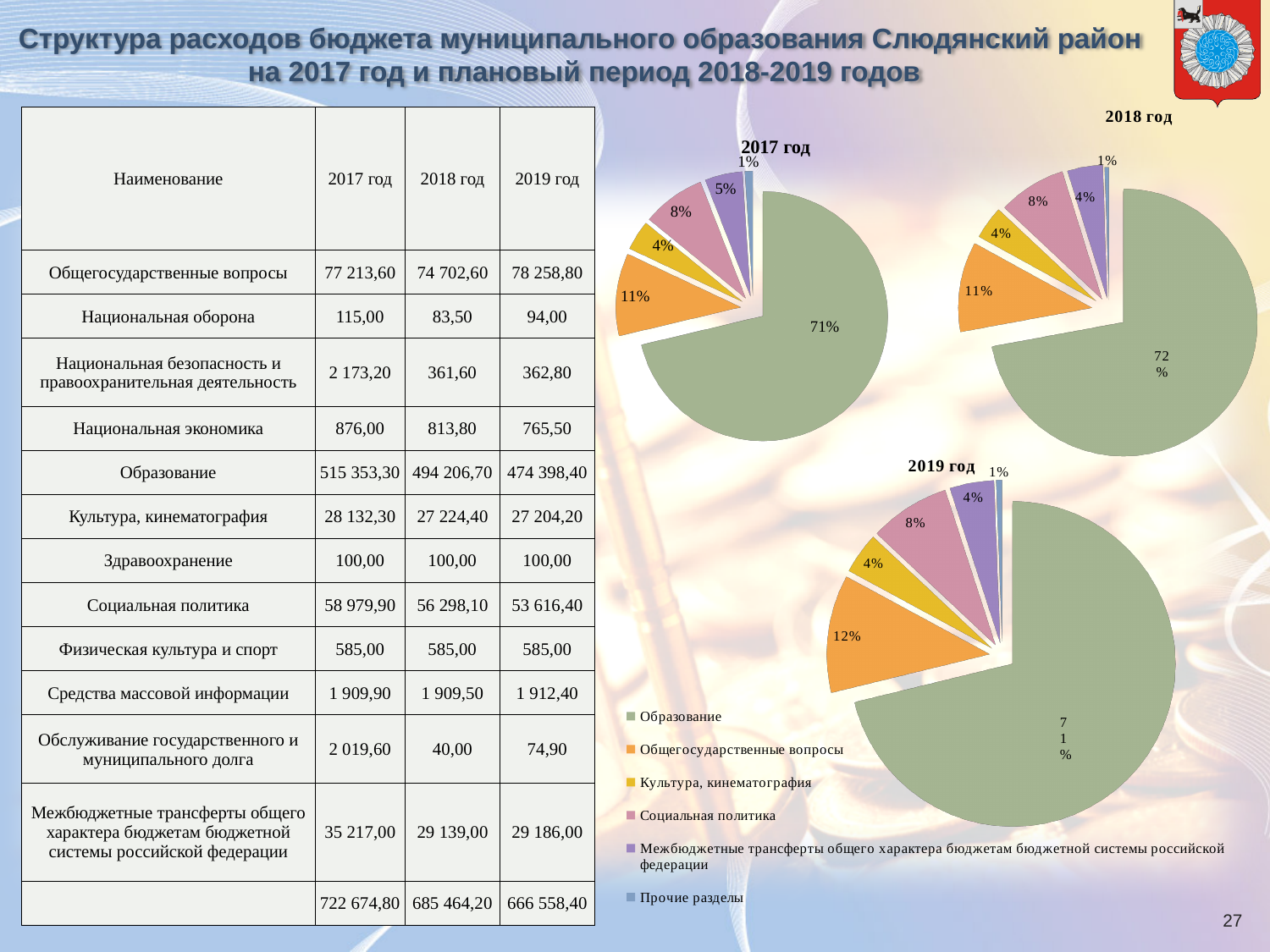
In the 2017 год pie chart, what share does Образование have? 71% In the 2019 год pie chart, what share does Общегосударственные вопросы have? 12% In the 2017 год pie chart, what share does Межбюджетные трансферты общего характера бюджетам бюджетной системы российской федерации have? 5% In the 2018 год pie chart, which category has the smallest slice? Прочие разделы In the 2019 год pie chart, which category has the largest slice? Образование What kind of charts are shown on the slide? pie charts How many categories does the legend list for the pie charts? 6 In the 2019 год pie chart, what is the difference in percentage points between the Образование slice and the Общегосударственные вопросы slice? 59 How many pie charts are on the slide? 3 In the 2017 год pie chart, which is larger: the slice for Общегосударственные вопросы or the slice for Социальная политика? Общегосударственные вопросы